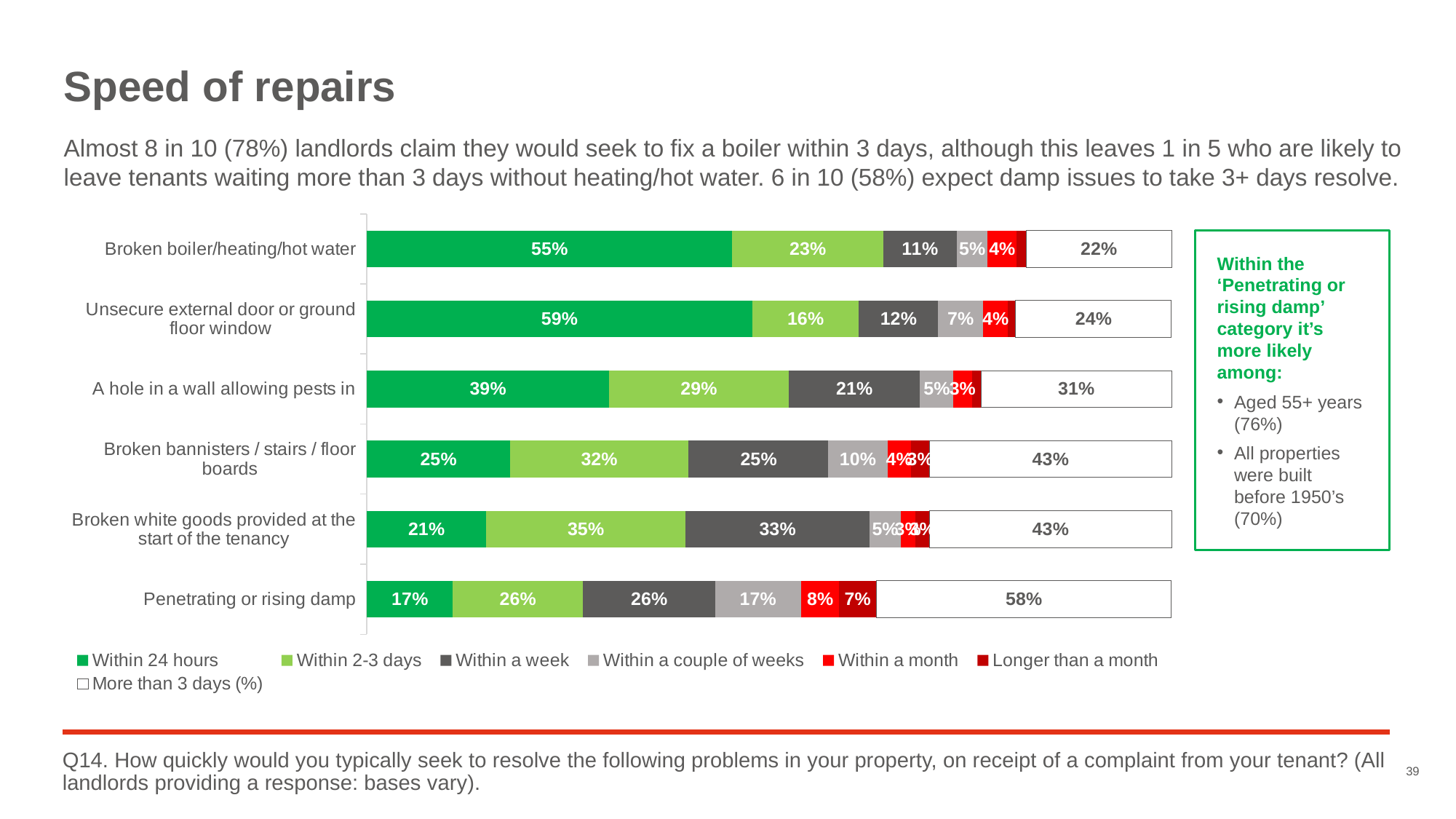
Which problem has the highest 'Within 24 hours' percentage? Unsecure external door or ground floor window Which has a larger 'Within a week' value: broken white goods provided at the start of the tenancy or a hole in a wall allowing pests in? Broken white goods provided at the start of the tenancy What is the title of the slide? Speed of repairs What is the 'Within a couple of weeks' value for penetrating or rising damp? 17% How many entries does the chart legend list? 7 What is the 'Within 2-3 days' value for broken white goods provided at the start of the tenancy? 35% What is the difference in percentage points between the 'Within 24 hours' values for broken boiler/heating/hot water and penetrating or rising damp? 38 percentage points Which problem has the lowest 'Within 24 hours' percentage? Penetrating or rising damp What type of chart is shown on the slide? Bar chart What percentage of landlords would fix an unsecure external door or ground floor window within 24 hours? 59% What is the 'More than 3 days (%)' value for penetrating or rising damp? 58% How many problem categories are shown in the chart? 6